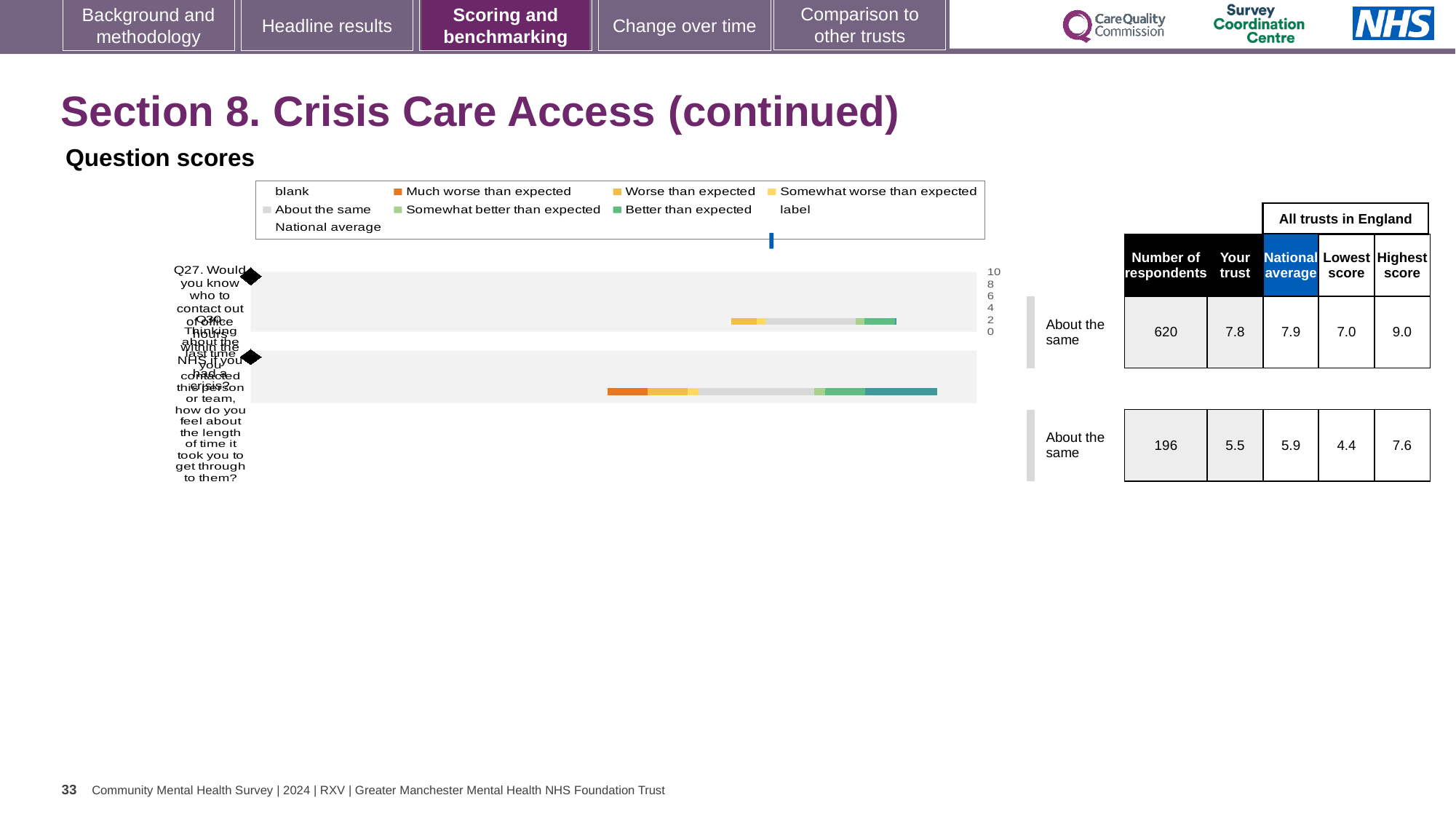
What is the highest score among all trusts in England for Q30? 7.6 What is the difference between the highest and lowest scores for Q30? 3.2 What benchmark category is shown for Q27 in the chart? About the same How many more respondents answered Q27 than Q30? 424 Which question has the larger 'Your trust' score, Q27 or Q30? Q27 Is the 'Your trust' score for Q30 greater or less than 6? less What is the 'Your trust' score for Q27? 7.8 What is the national average score for Q30? 5.9 What kind of chart is used to show the question scores on this slide? bar chart What is the difference between the national average and the 'Your trust' score for Q27? 0.1 How many questions are plotted in the question scores chart? 2 How many respondents answered Q27? 620